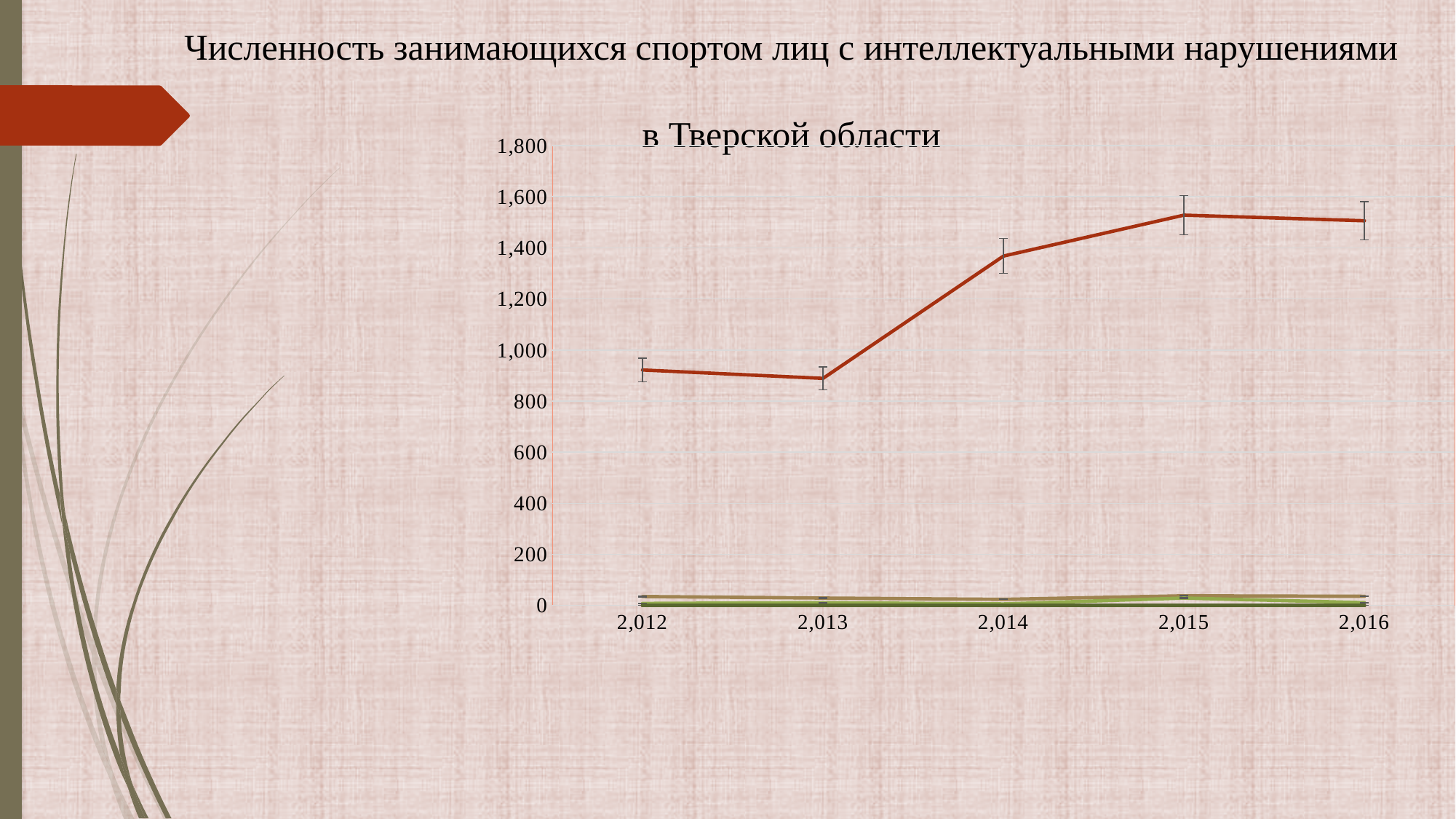
Is the value of the red line for 2,014 greater or less than 1,200? greater What kind of chart is shown on the slide? line chart Is the value of the red line for 2,013 greater or less than 800? greater How many years are shown along the x axis? 5 On the red line, which year has the larger value, 2,012 or 2,015? 2,015 Is the value of the red line for 2,012 greater or less than 1,000? less On the red line, which year has the larger value, 2,013 or 2,014? 2,014 What is the last year shown on the x axis? 2,016 Does the red line rise or fall between 2,013 and 2,015? rise What is the first year shown on the x axis? 2,012